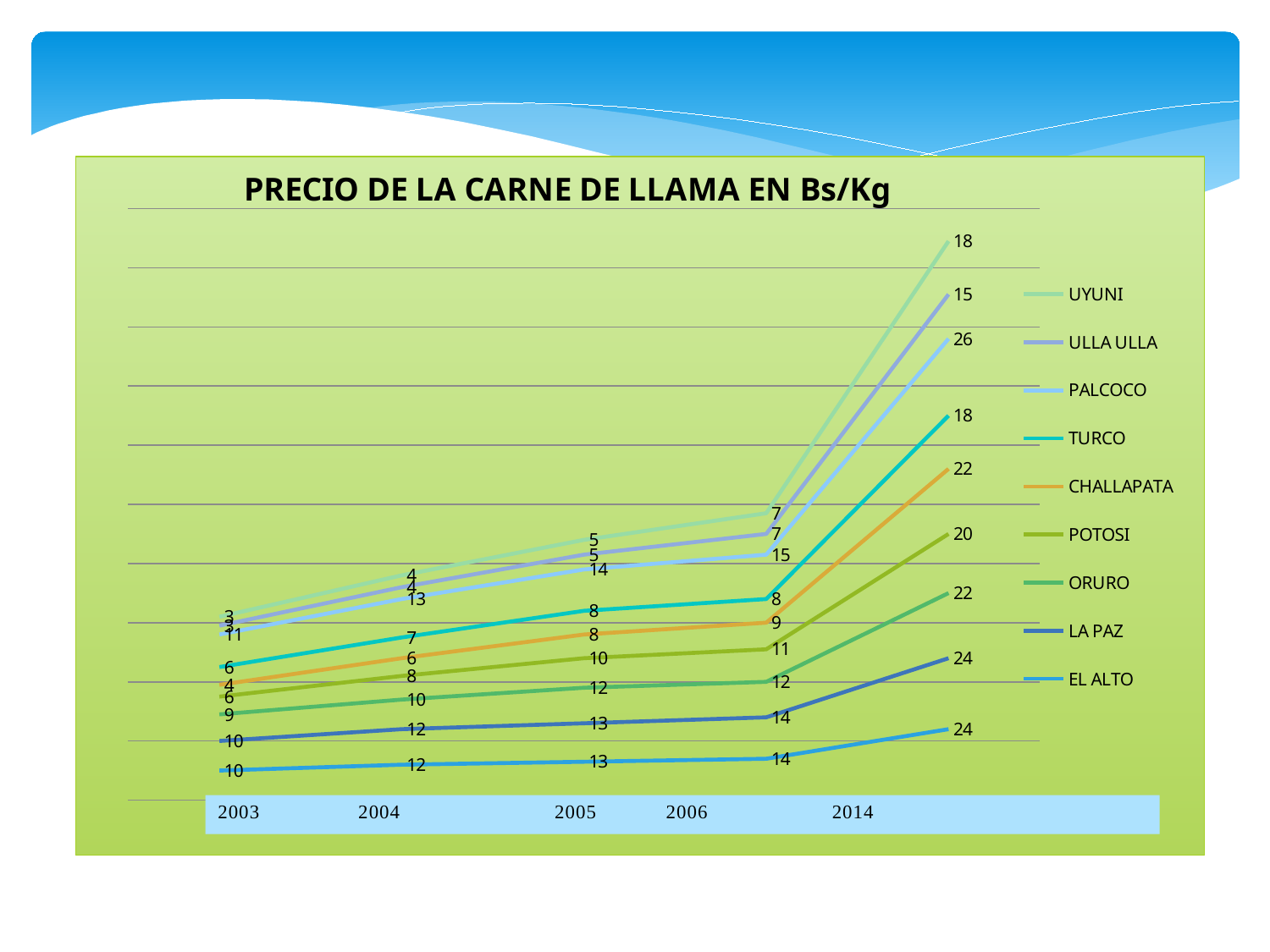
How many series does the legend list? 9 What is the data label for CHALLAPATA at the final (2014) point? 22 At the final (2014) point, which has the larger label: UYUNI or ULLA ULLA? UYUNI Which series has the lowest data label at the final (2014) point? ULLA ULLA What is the data label for EL ALTO at the first (2003) point? 10 Do the EL ALTO values rise or fall from 2003 to 2014? rise Which series has the highest data label at the final (2014) point? PALCOCO What is the difference between the LA PAZ labels at the final (2014) point and the first (2003) point? 14 What is the data label for PALCOCO at the final (2014) point? 26 What is the title of the chart? PRECIO DE LA CARNE DE LLAMA EN Bs/Kg What type of chart is shown on the slide? line chart How many year categories are shown on the x axis? 5